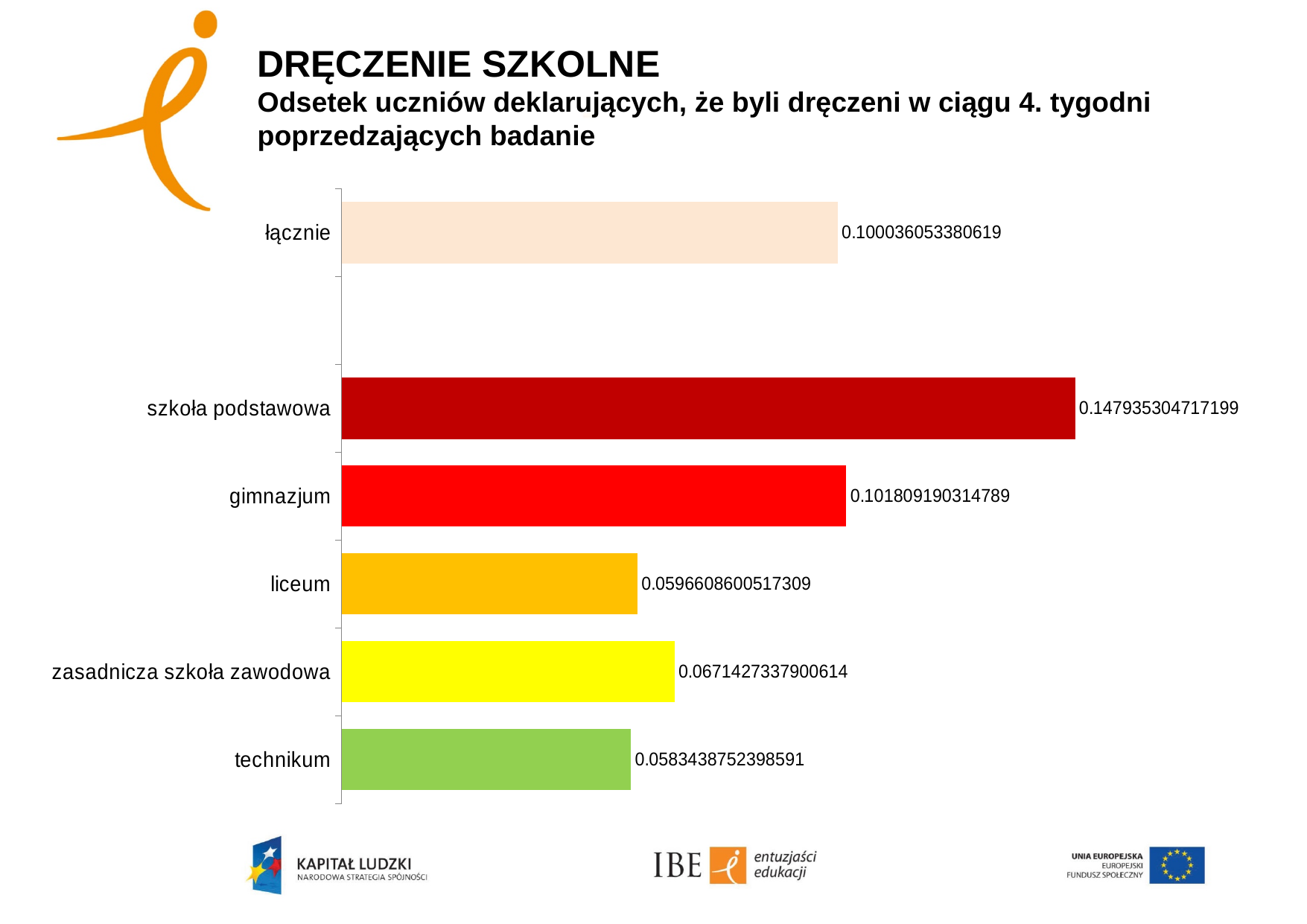
What is the value for technikum? 0.0583438752398591 What is the value for liceum? 0.0596608600517309 What kind of chart is shown on the slide? bar chart What is the value for gimnazjum? 0.101809190314789 Which category has the highest value? szkoła podstawowa How many categories are shown in the chart? 6 What is the value for zasadnicza szkoła zawodowa? 0.0671427337900614 Which category has the lowest value? technikum Which is larger, the value for gimnazjum or the value for zasadnicza szkoła zawodowa? gimnazjum What is the value for łącznie? 0.100036053380619 What is the value for szkoła podstawowa? 0.147935304717199 What is the main title of the slide? DRĘCZENIE SZKOLNE